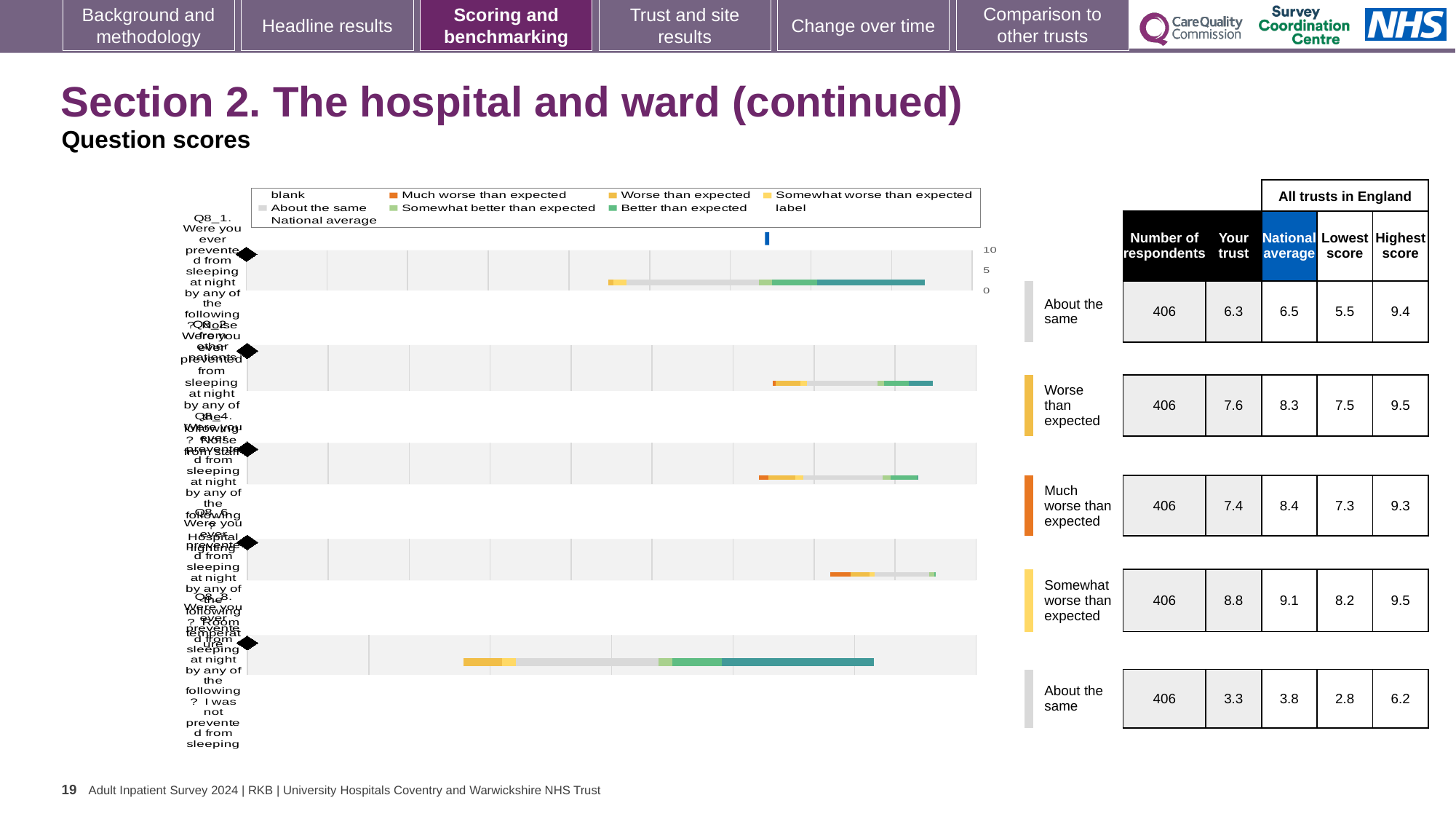
What colour does the legend use for 'Better than expected'? teal How many question bars are plotted in the chart? 5 Which question has the highest 'Your trust' score in the table? the fourth question (Somewhat worse than expected), 8.8 Which question has the lowest 'Your trust' score in the table? the bottom question (About the same), 3.3 What kind of chart is shown on the slide? bar chart In the table beside the chart, what is the highest score for the third question (benchmarked 'Much worse than expected')? 9.3 For the top question, what is the difference between the highest score and the lowest score? 3.9 What colour does the legend use for 'Much worse than expected'? orange In the table beside the chart, what is the 'Your trust' score for the first (top) question? 6.3 For the second question, is the 'Your trust' score or the national average larger? national average How many respondents are listed for the bottom question in the table? 406 In the table beside the chart, what is the national average for the second question (benchmarked 'Worse than expected')? 8.3